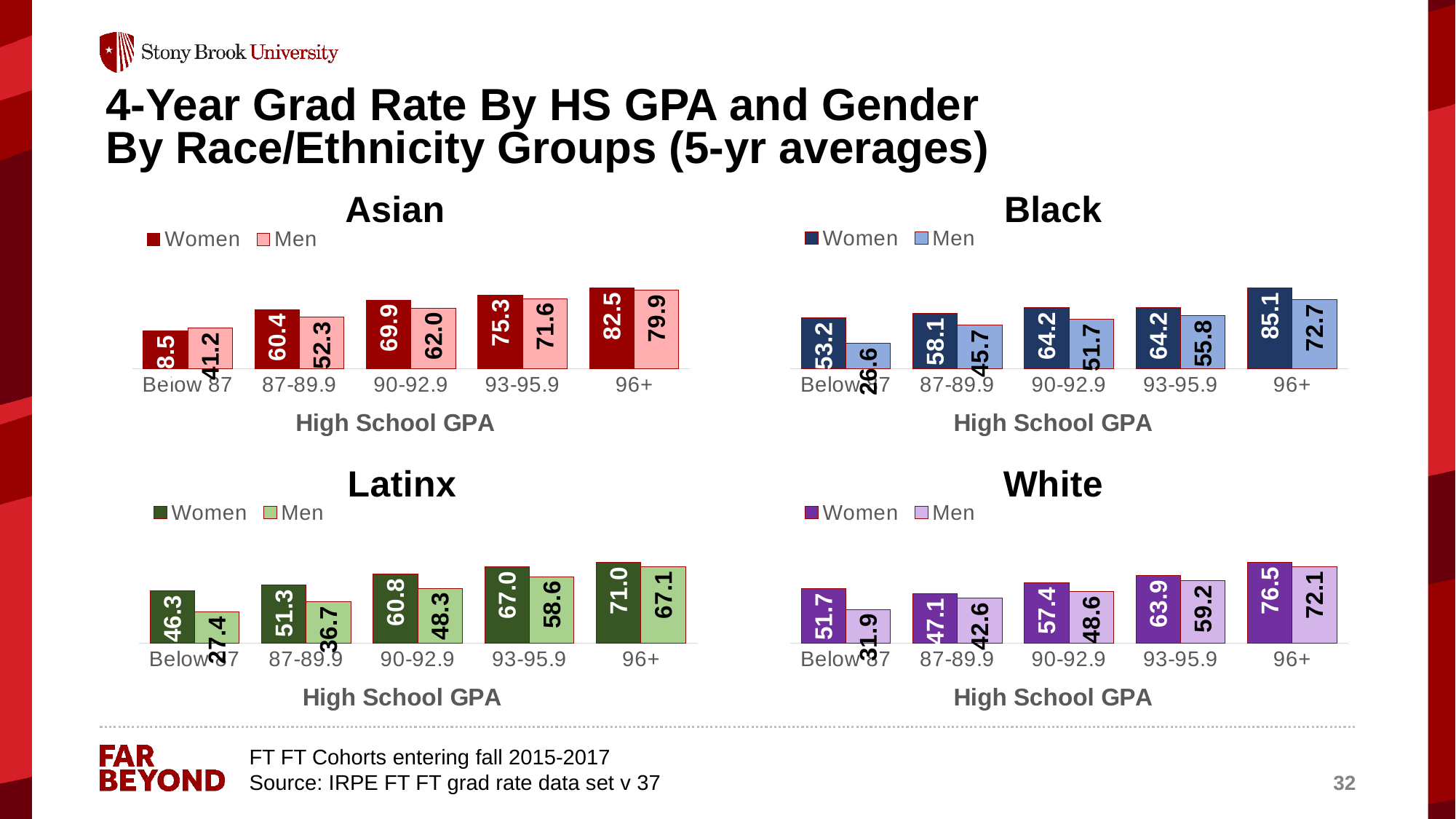
What type of chart is the Black chart? Bar chart How many GPA categories are shown on the x axis of the Latinx chart? 5 How many series does the legend of the White chart list? 2 In the White chart, what is the difference between Women and Men in the 96+ GPA category? 4.4 In the Black chart, which GPA category has the highest value for Women? 96+ In the Latinx chart, what is the value for Women in the 93-95.9 GPA category? 67.0 In the Black chart, what is the difference between Women and Men in the Below 87 GPA category? 26.6 In the Asian chart, what is the value for Women in the 96+ GPA category? 82.5 In the Black chart, what is the value for Men in the Below 87 GPA category? 26.6 In the Asian chart, which is larger: Men in the 93-95.9 category or Women in the 87-89.9 category? Men in 93-95.9 In the White chart, what is the value for Men in the 87-89.9 GPA category? 42.6 In the Latinx chart, which GPA category has the lowest value for Men? Below 87